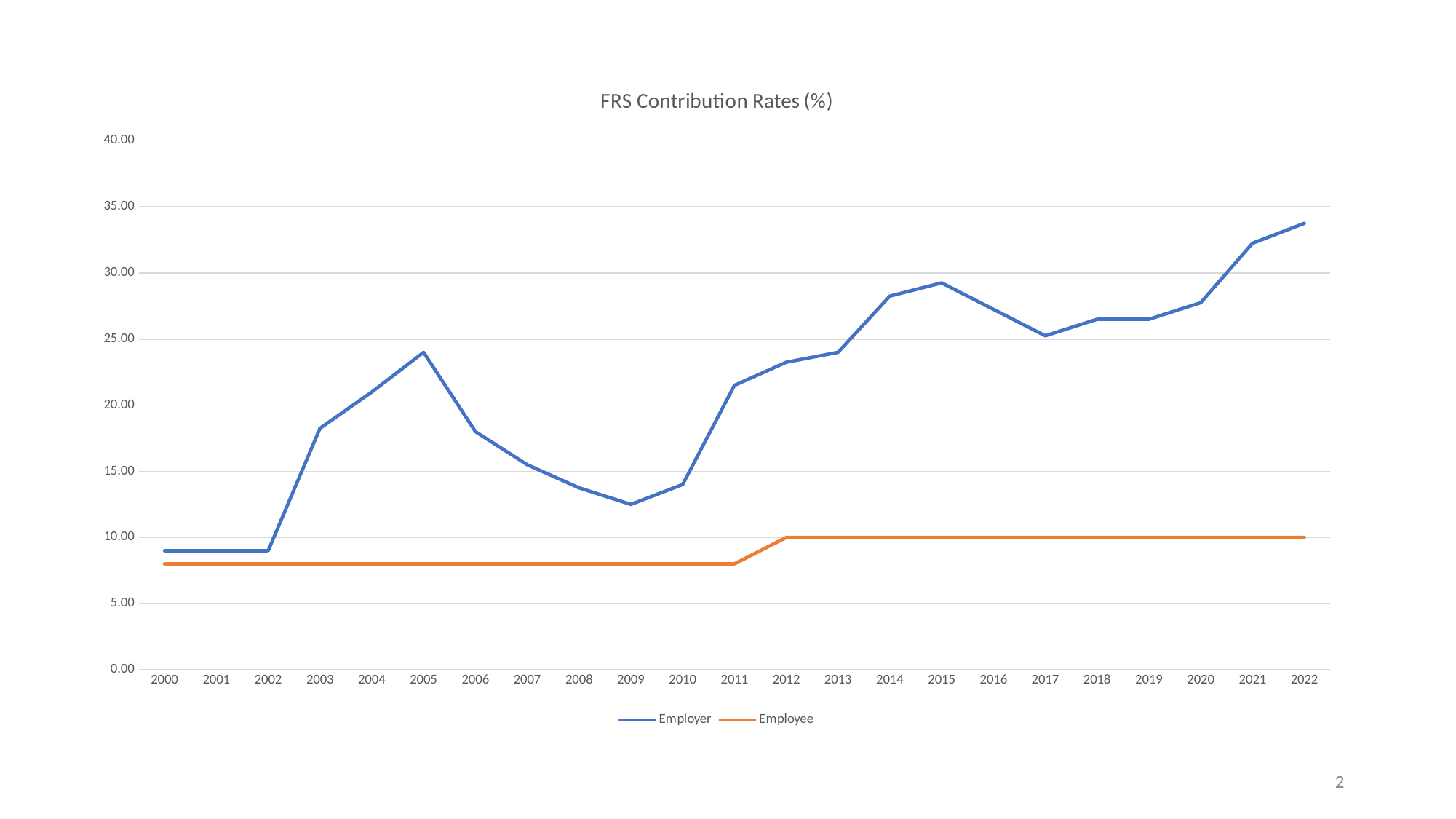
What is the Employee contribution rate in 2015? 10.00 How many years are plotted along the x axis? 23 Does the Employer contribution rate rise or fall from 2017 to 2022? rise What kind of chart is shown on the slide? line chart In which year is the Employer contribution rate lowest? 2000, 2001 and 2002 (tied at the lowest) What is the title of the chart? FRS Contribution Rates (%) Is the Employer value for 2005 greater or less than 20.00? greater Which series has the larger value in 2010, Employer or Employee? Employer In which year is the Employer contribution rate highest? 2022 How many series does the legend list? 2 Is the Employer value for 2009 greater or less than 15.00? less Is the Employee value for 2005 greater or less than 10.00? less